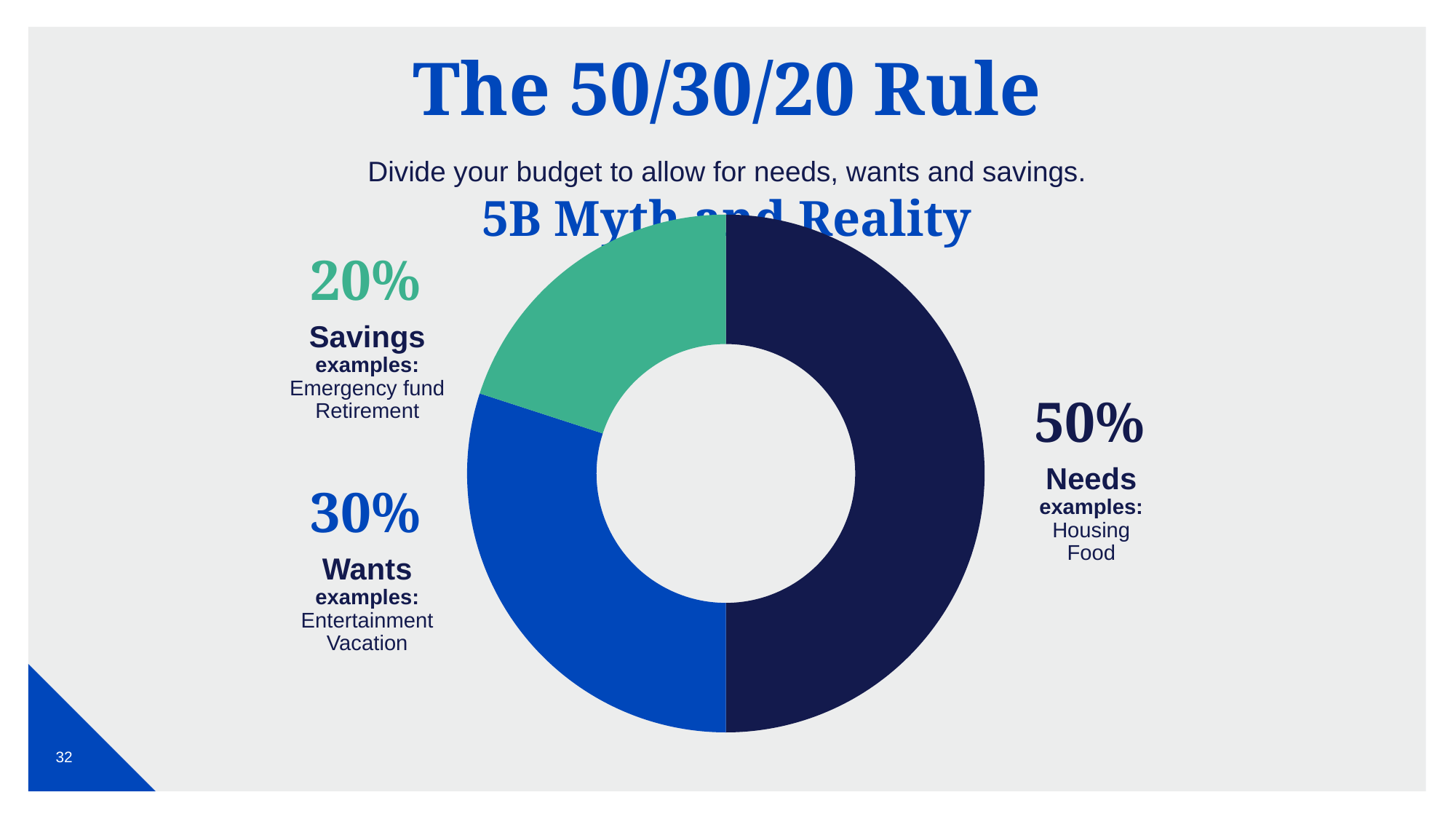
Which category has the smallest slice of the chart? Savings What is the title of the slide containing the chart? The 50/30/20 Rule What share of the budget does the Needs slice represent? 50% How many categories are shown in the chart? 3 What is the difference in percentage points between the Wants and Savings slices? 10 What share of the budget does the Savings slice represent? 20% What colour is the Savings slice of the chart? Green What is the difference in percentage points between the Needs and Wants slices? 20 What kind of chart is shown on the slide? Doughnut (pie) chart Which category has the largest slice of the chart? Needs What share of the budget does the Wants slice represent? 30% Which is larger, the Wants slice or the Savings slice? Wants